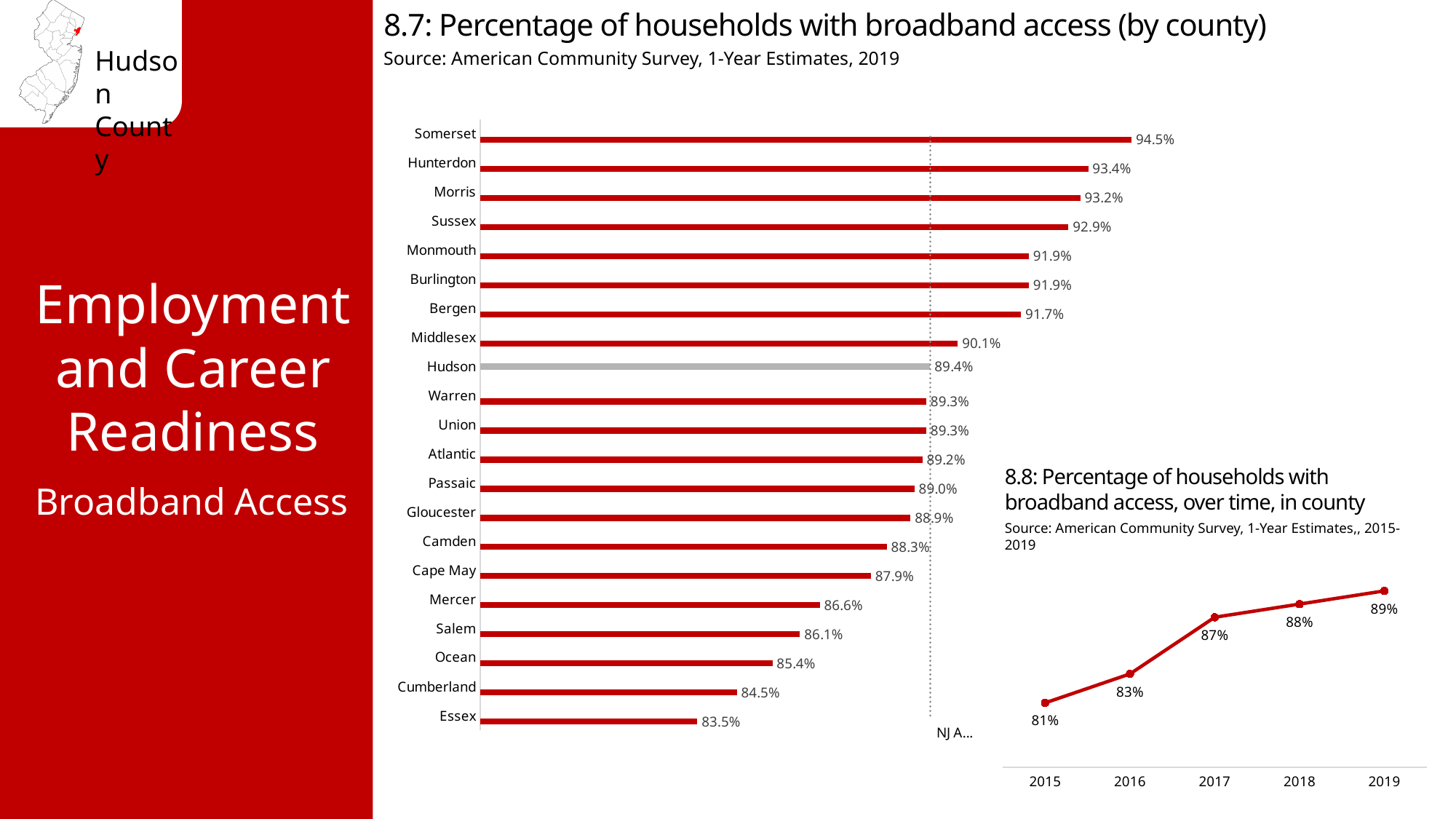
In chart 8.7, which has a higher value, Bergen or Middlesex? Bergen What kind of chart is chart 8.7? Bar chart In chart 8.8, do the values rise or fall from 2015 to 2019? Rise In chart 8.8 (Percentage of households with broadband access over time in county), what is the value for 2017? 87% In chart 8.8, how many years are plotted? 5 In chart 8.7, which county has the highest percentage of households with broadband access? Somerset In chart 8.7, what is the value for Cumberland? 84.5% In chart 8.7, what is the difference between Somerset's value and Essex's value? 11.0% In chart 8.8, what is the difference between the 2019 value and the 2015 value? 8% In chart 8.7, which county has the lowest percentage of households with broadband access? Essex In chart 8.7, how many counties are shown? 21 In chart 8.7 (Percentage of households with broadband access by county), what is the value for Hudson? 89.4%